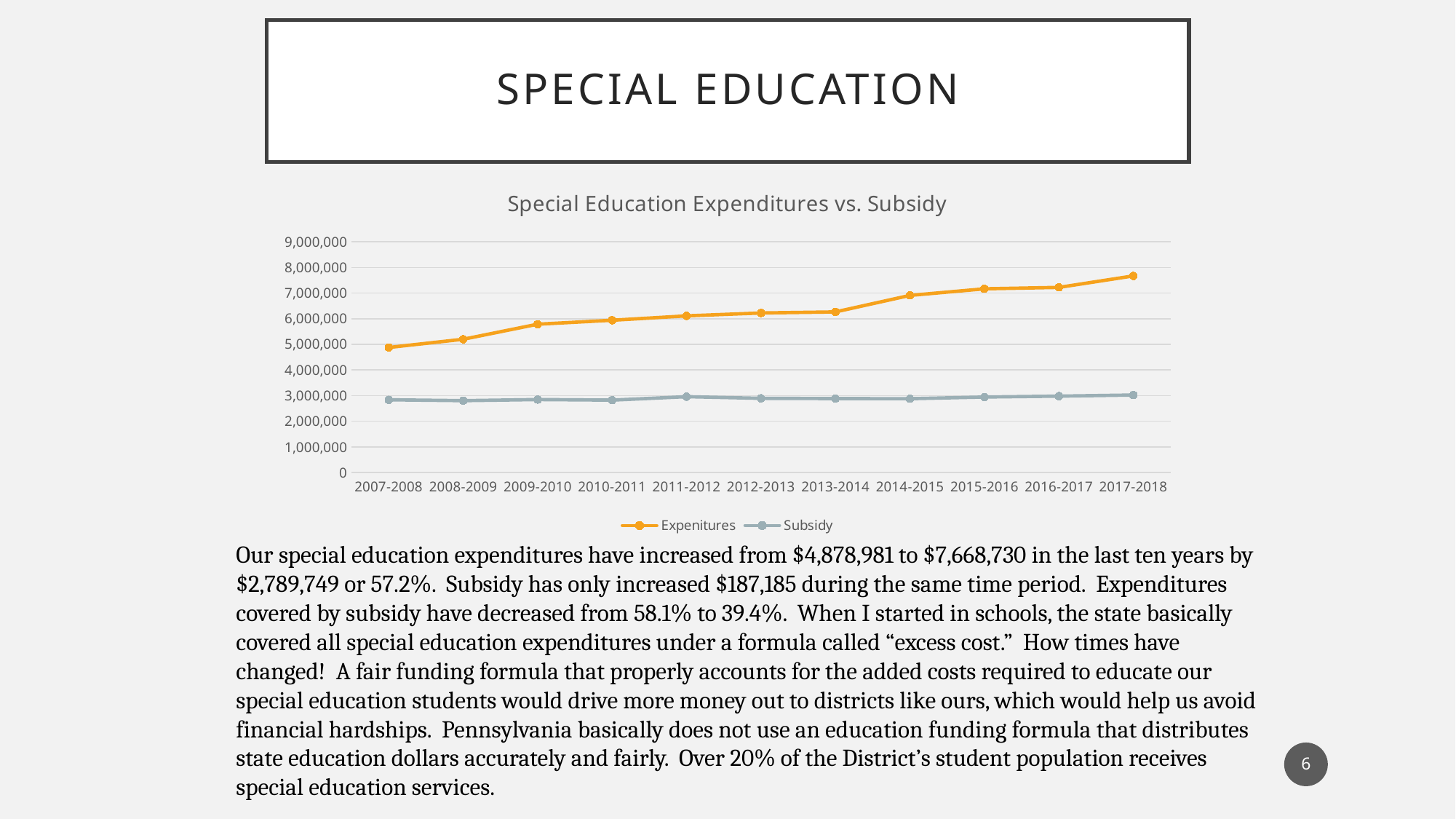
Is the Subsidy value for 2011-2012 greater or less than 4,000,000? less How many school years are plotted along the x axis of the chart? 11 Which school year has the lowest Expenditures value? 2007-2008 What kind of chart is shown on the slide? Line chart Which school year has the highest Expenditures value? 2017-2018 What are the two series named in the chart legend? Expenitures and Subsidy Is the Expenditures value for 2017-2018 greater or less than 7,000,000? greater How many series does the legend of the chart list? 2 What is the title of the chart? Special Education Expenditures vs. Subsidy Is the Expenditures value for 2009-2010 greater or less than 5,000,000? greater Do the Expenditures values rise or fall from 2007-2008 to 2017-2018? Rise In 2012-2013, which is larger, Expenditures or Subsidy? Expenditures